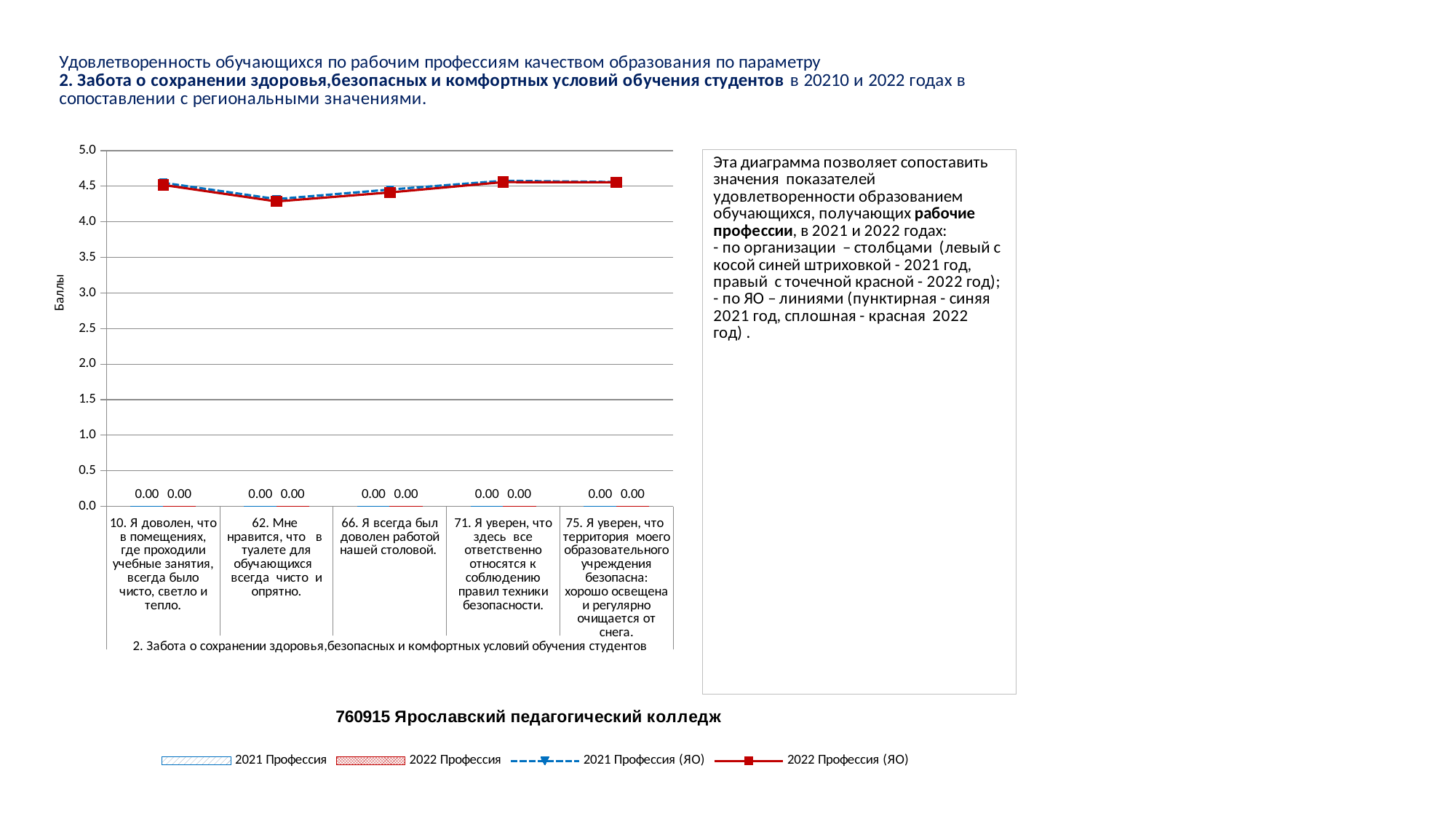
Does the 2022 Профессия (ЯО) line rise or fall from category 62 to category 71? rise What is the data label value for the 2022 Профессия bar in category "62. Мне нравится, что в туалете для обучающихся всегда чисто и опрятно."? 0.00 Is the value of the 2022 Профессия (ЯО) line for category "71. Я уверен, что здесь все ответственно относятся к соблюдению правил техники безопасности." greater or less than 4.0? greater What is the data label value for the 2021 Профессия bar in category "10. Я доволен, что в помещениях, где проходили учебные занятия, всегда было чисто, светло и тепло."? 0.00 How many series does the chart legend list? 4 On the 2022 Профессия (ЯО) line, which is larger: the value for category 10 or the value for category 62? Category 10 What is the title of the vertical axis of the chart? Баллы How many categories are shown on the x axis of the chart? 5 Is the value of the 2022 Профессия (ЯО) line for category "62. Мне нравится, что в туалете для обучающихся всегда чисто и опрятно." greater or less than 4.5? less Which category has the lowest value on the 2022 Профессия (ЯО) line? 62. Мне нравится, что в туалете для обучающихся всегда чисто и опрятно. What kind of chart is shown on the slide? Combined bar and line chart What is the title shown below the chart? 760915 Ярославский педагогический колледж